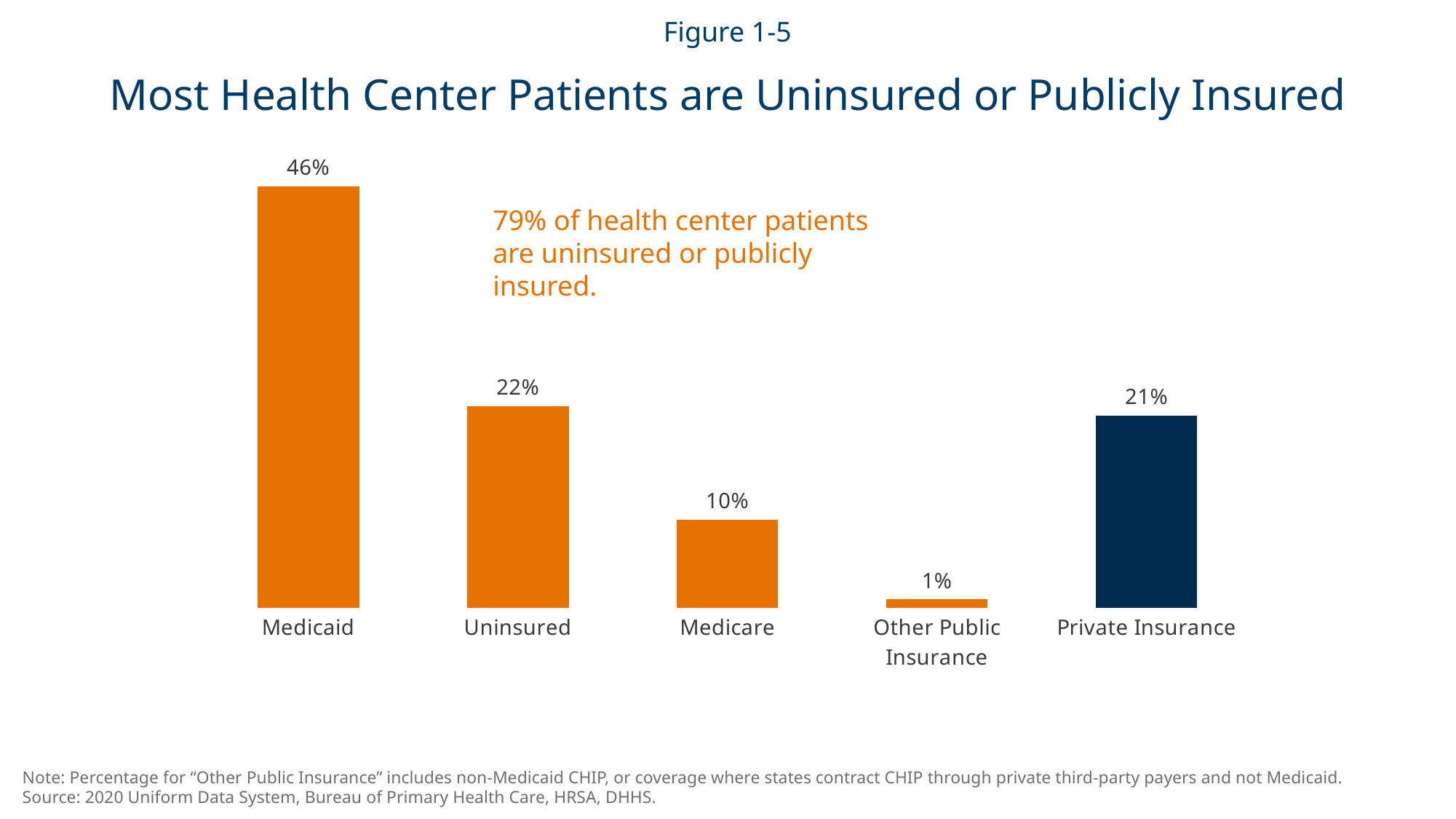
What percentage of health center patients are covered by Medicaid? 46% What percentage of health center patients are uninsured? 22% Which category has the lowest value? Other Public Insurance Which bar is shown in a different colour (dark blue) from the others? Private Insurance What is the value shown for Other Public Insurance? 1% How many categories are shown in the chart? 5 What is the difference between the Medicaid and Uninsured percentages? 24% What is the value shown for Private Insurance? 21% Which category has the highest value? Medicaid What is the difference between the Medicare and Other Public Insurance percentages? 9% What kind of chart is shown on the slide? Bar chart Which is larger, the value for Medicare or the value for Private Insurance? Private Insurance